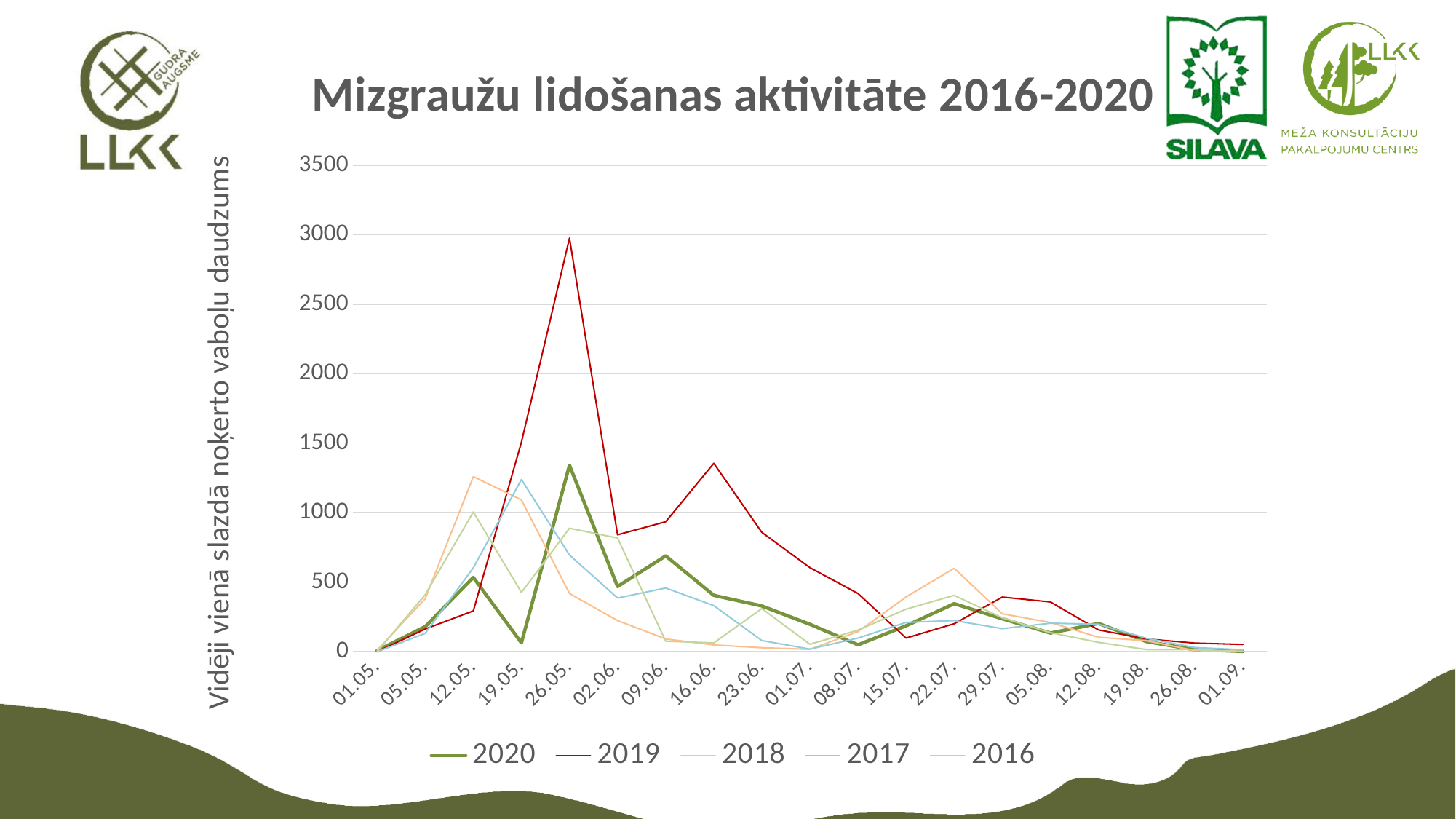
Which series reaches the highest value on the chart? 2019 On 12.05., which series has the larger value, 2018 or 2020? 2018 How many series does the legend list? 5 What kind of chart is shown on the slide? line chart Is the value for 2020 on 19.05. greater or less than 500? less How many dates are shown along the x axis? 19 Is the value for 2020 on 26.05. greater or less than 1000? greater Does the 2019 series rise or fall between 26.05. and 02.06.? fall Is the value for 2019 on 02.06. greater or less than 1000? less What is the title of the chart? Mizgraužu lidošanas aktivitāte 2016-2020 On which date does the 2019 series reach its peak? 26.05.